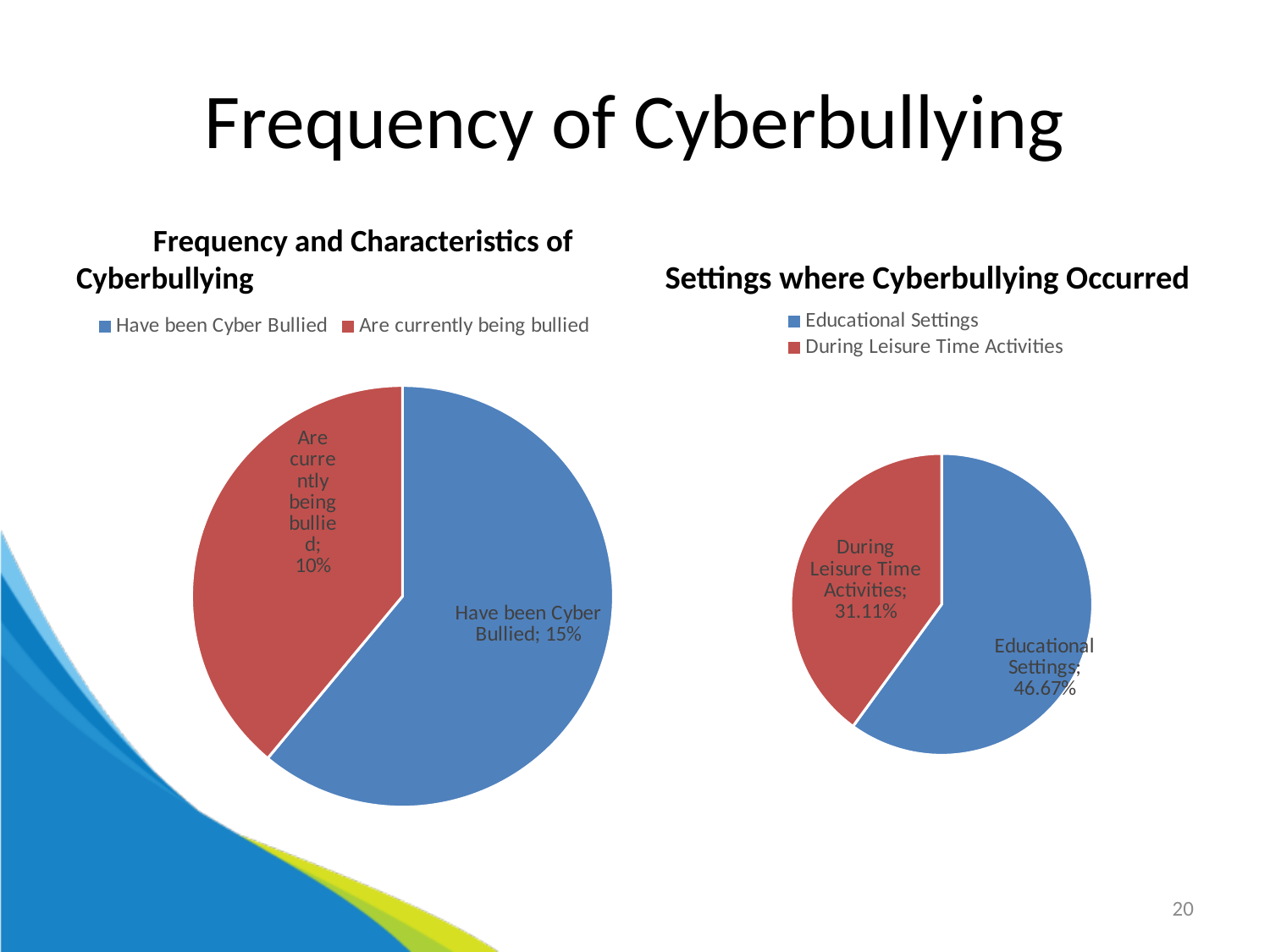
In the 'Settings where Cyberbullying Occurred' chart, which slice is the smallest? During Leisure Time Activities In the 'Frequency and Characteristics of Cyberbullying' chart, what value is shown for 'Have been Cyber Bullied'? 15% In the 'Settings where Cyberbullying Occurred' chart, what value is shown for 'Educational Settings'? 46.67% In the 'Frequency and Characteristics of Cyberbullying' chart, what value is shown for 'Are currently being bullied'? 10% In the 'Settings where Cyberbullying Occurred' chart, what value is shown for 'During Leisure Time Activities'? 31.11% In the 'Settings where Cyberbullying Occurred' chart, which is larger: 'Educational Settings' or 'During Leisure Time Activities'? Educational Settings In the 'Frequency and Characteristics of Cyberbullying' chart, what is the difference between the values for 'Have been Cyber Bullied' and 'Are currently being bullied'? 5% In the 'Settings where Cyberbullying Occurred' chart, what colour is the 'Educational Settings' slice? Blue How many slices does the 'Frequency and Characteristics of Cyberbullying' chart have? 2 What type of chart is the 'Settings where Cyberbullying Occurred' chart? Pie chart In the 'Frequency and Characteristics of Cyberbullying' chart, which slice is the largest? Have been Cyber Bullied In the 'Settings where Cyberbullying Occurred' chart, what is the difference between the values for 'Educational Settings' and 'During Leisure Time Activities'? 15.56%